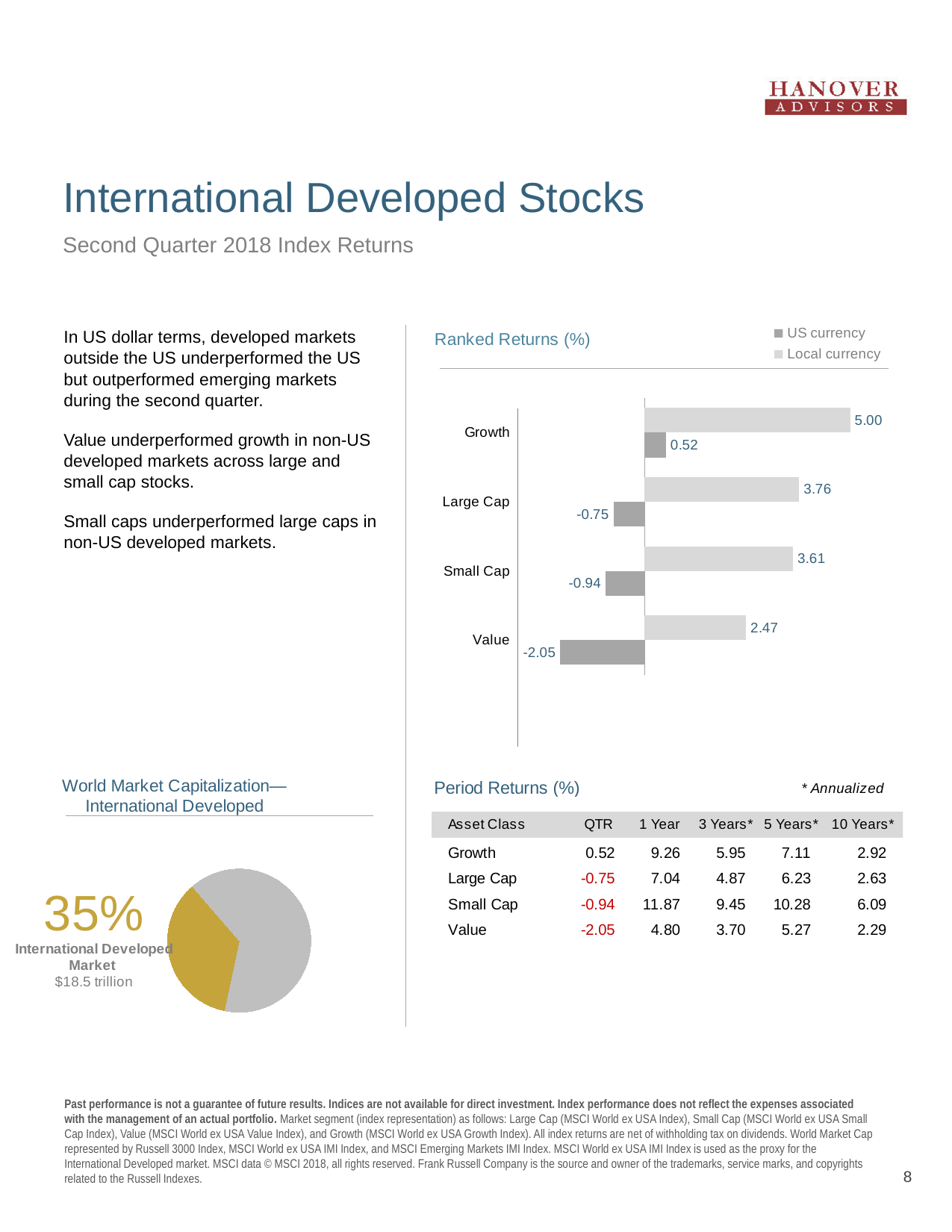
How many categories are shown in the Ranked Returns (%) chart? 4 In the Ranked Returns (%) chart, what is the US currency value for Value? -2.05 In the Ranked Returns (%) chart, which is larger: the US currency value for Large Cap or the US currency value for Small Cap? Large Cap What kind of chart is the Ranked Returns (%) chart? Bar chart How many series does the legend of the Ranked Returns (%) chart list? 2 In the Ranked Returns (%) chart, what is the US currency value for Growth? 0.52 In the Ranked Returns (%) chart, which category has the lowest US currency value? Value In the Ranked Returns (%) chart, what is the Local currency value for Large Cap? 3.76 What are the two legend entries in the Ranked Returns (%) chart? US currency and Local currency In the Ranked Returns (%) chart, which category has the highest Local currency value? Growth In the Ranked Returns (%) chart, what is the difference between the Local currency and US currency values for Small Cap? 4.55 In the World Market Capitalization—International Developed pie chart, what share does the International Developed Market slice represent? 35%